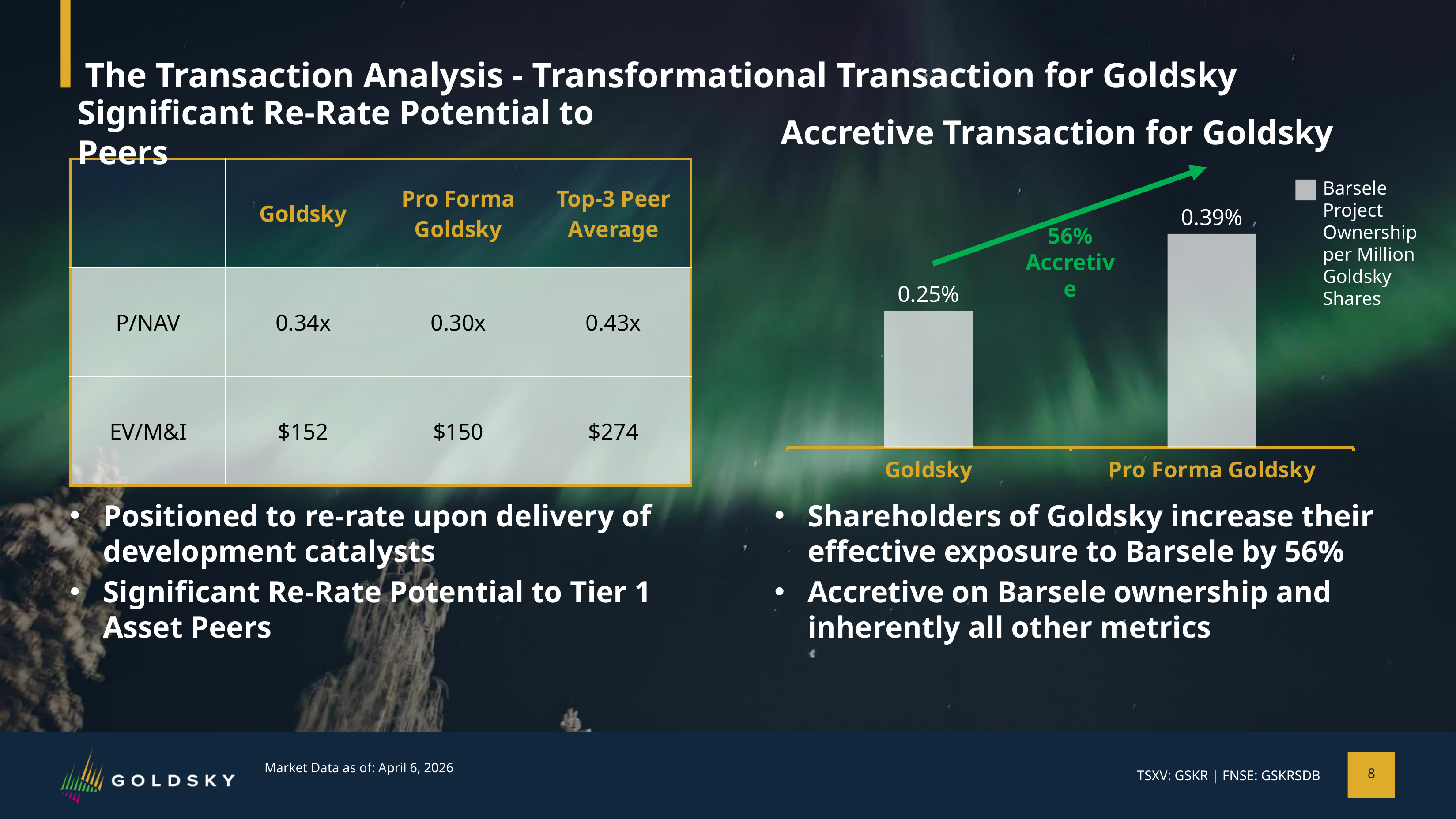
What kind of chart is shown on the right side of the slide? Bar chart Which category has the highest value in the bar chart? Pro Forma Goldsky How many bars are shown in the bar chart? 2 What is the legend entry of the bar chart? Barsele Project Ownership per Million Goldsky Shares Do the values in the bar chart rise or fall from Goldsky to Pro Forma Goldsky? Rise What is the value for Pro Forma Goldsky in the bar chart? 0.39% What is the value for Goldsky in the bar chart? 0.25% What percentage accretion is annotated on the green arrow in the bar chart? 56% What is the difference between the Pro Forma Goldsky and Goldsky values in the bar chart? 0.14% Which category has the lowest value in the bar chart? Goldsky How many series does the legend of the bar chart list? 1 Which is larger in the bar chart, the value for Goldsky or the value for Pro Forma Goldsky? Pro Forma Goldsky